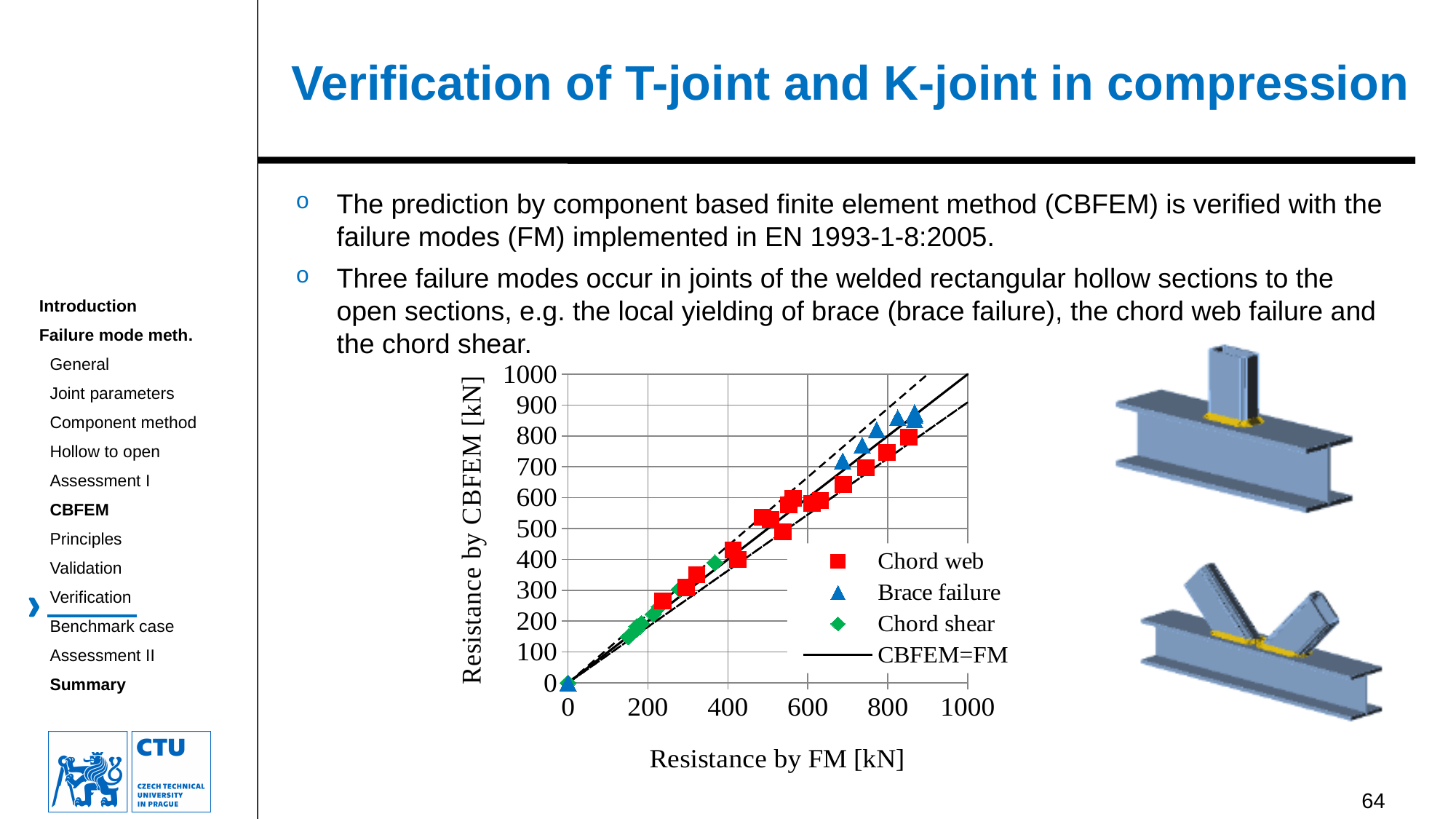
What is the title of the y axis of the chart? Resistance by CBFEM [kN] What kind of chart is shown on the slide? scatter chart Do the plotted points rise or fall as the resistance by FM increases along the x axis? rise How many entries does the chart legend list? 4 Which legend entry is represented by the solid black line in the chart? CBFEM=FM What is the maximum value shown on the y axis of the chart? 1000 Which series occupies the lowest range of resistance values in the chart? Chord shear Which series in the chart is plotted with blue triangle markers? Brace failure What is the title of the x axis of the chart? Resistance by FM [kN] Which series in the chart is plotted with green diamond markers? Chord shear Are all Chord shear points' resistance by FM values greater or less than 600 kN? less Is the highest Brace failure point's resistance by CBFEM greater or less than 800 kN? greater